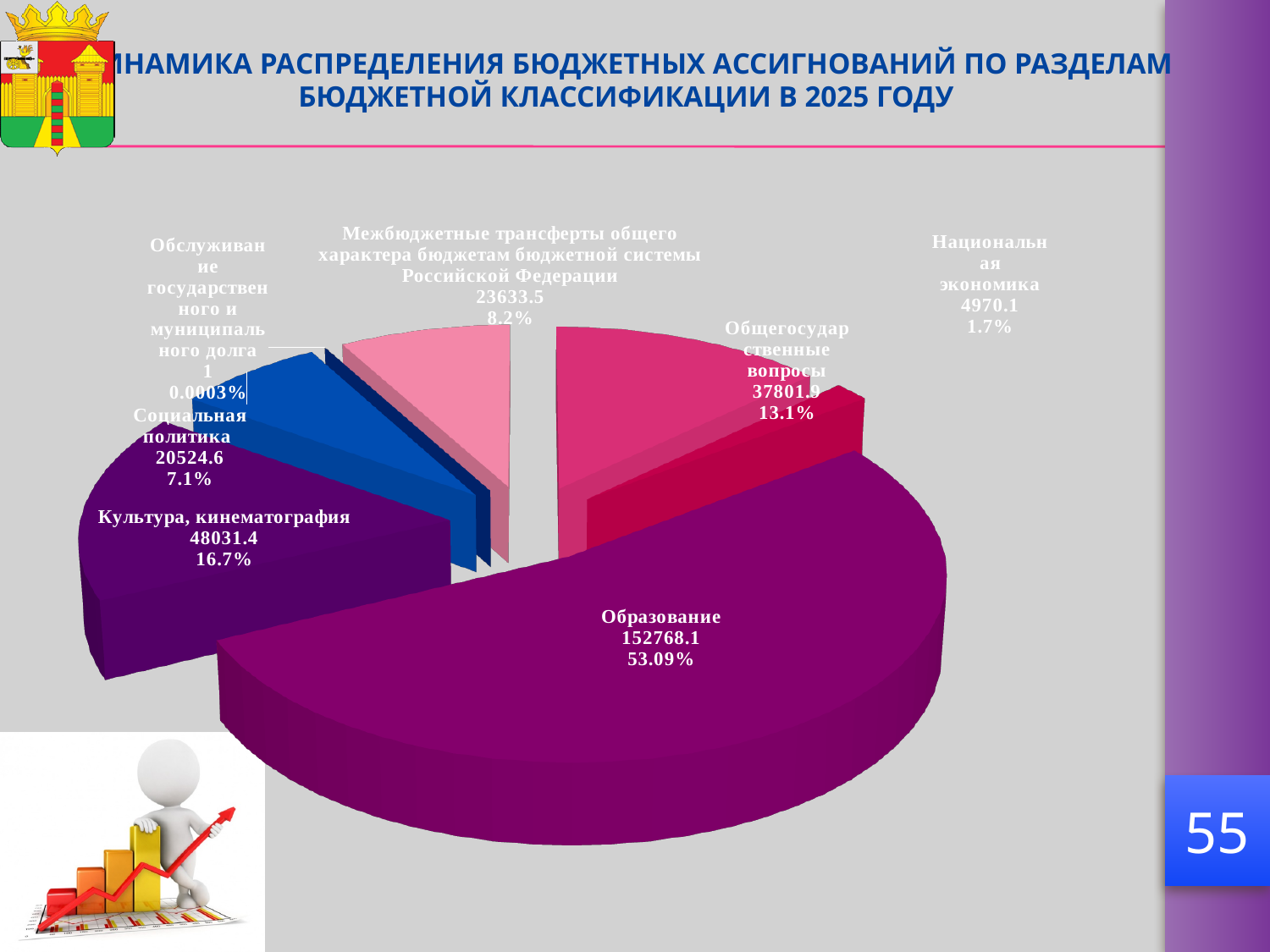
What is the value shown for Образование? 152768.1 What share of the pie does Образование account for? 53.09% How many categories are shown in the pie chart? 7 What is the value shown for Культура, кинематография? 48031.4 What is the difference between the values for Образование and Культура, кинематография? 104736.7 What is the value shown for Национальная экономика? 4970.1 What percentage is shown for Социальная политика? 7.1% What kind of chart is shown on the slide? Pie chart What percentage is shown for Межбюджетные трансферты общего характера бюджетам бюджетной системы Российской Федерации? 8.2% Which category has the smallest share of the pie? Обслуживание государственного и муниципального долга Which category has the largest share of the pie? Образование Which is larger, Культура, кинематография or Общегосударственные вопросы? Культура, кинематография